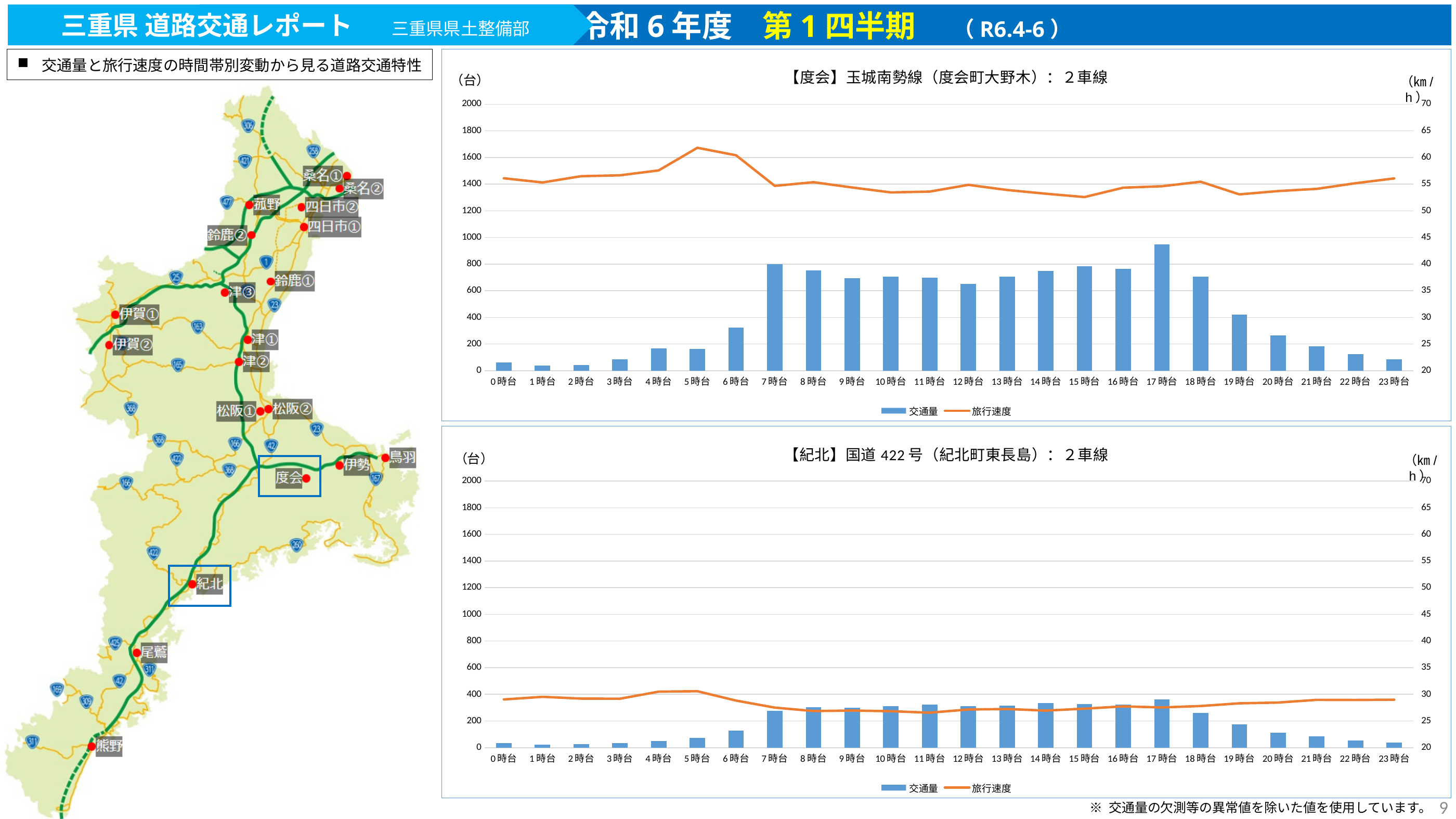
In the bottom chart (【紀北】国道422号), what kind of chart is used? Combined bar and line chart In the top chart (【度会】玉城南勢線), at which hour does the travel speed (旅行速度) line reach its peak? 5時台 In the bottom chart (【紀北】国道422号), is the traffic volume for 7時台 greater or less than 400? less In the top chart (【度会】玉城南勢線), how many series does the legend list? 2 In the top chart (【度会】玉城南勢線), how many hourly categories are shown on the x axis? 24 In the bottom chart (【紀北】国道422号), which is larger, the traffic volume for 7時台 or for 0時台? 7時台 In the top chart (【度会】玉城南勢線), at which hour is the traffic volume (交通量) bar highest? 17時台 In the top chart (【度会】玉城南勢線), does the traffic volume rise or fall from 0時台 to 7時台? rise In the bottom chart (【紀北】国道422号), what colour are the traffic volume (交通量) bars? Blue In the top chart (【度会】玉城南勢線), is the traffic volume for 0時台 greater or less than 200? less In the top chart (【度会】玉城南勢線), is the traffic volume for 7時台 greater or less than 600? greater